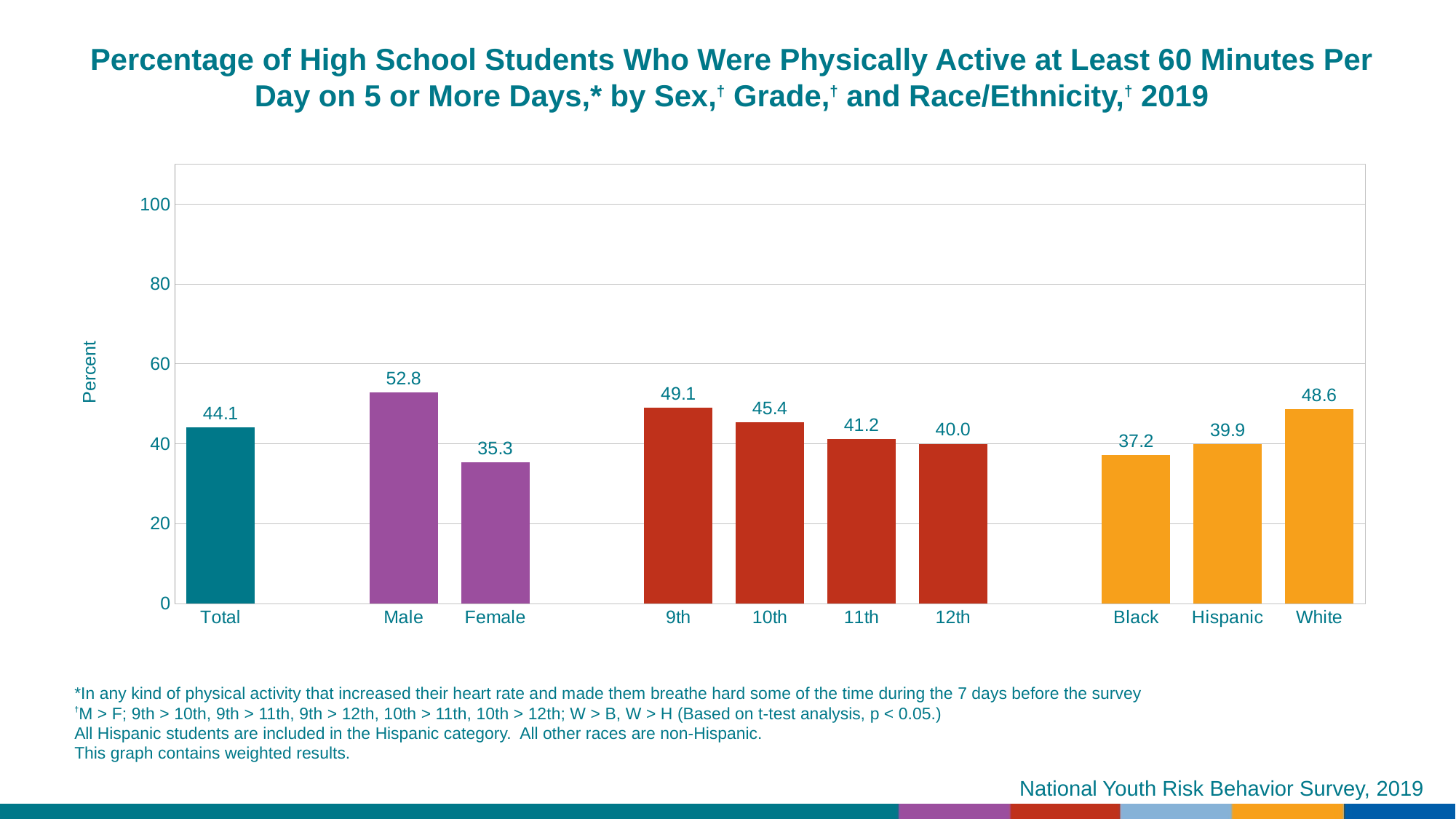
Which is larger, the value for 9th grade or the value for 12th grade? 9th How many categories are shown on the x axis? 10 Which category has the highest value? Male What is the difference between the values for Male and Female? 17.5 Do the values rise or fall from 9th grade to 12th grade? fall Which category has the lowest value? Female What is the value for 11th grade? 41.2 What is the value for Hispanic? 39.9 What is the difference between the values for White and Black? 11.4 What is the value for Total? 44.1 What is the value for Female? 35.3 What kind of chart is shown on the slide? bar chart